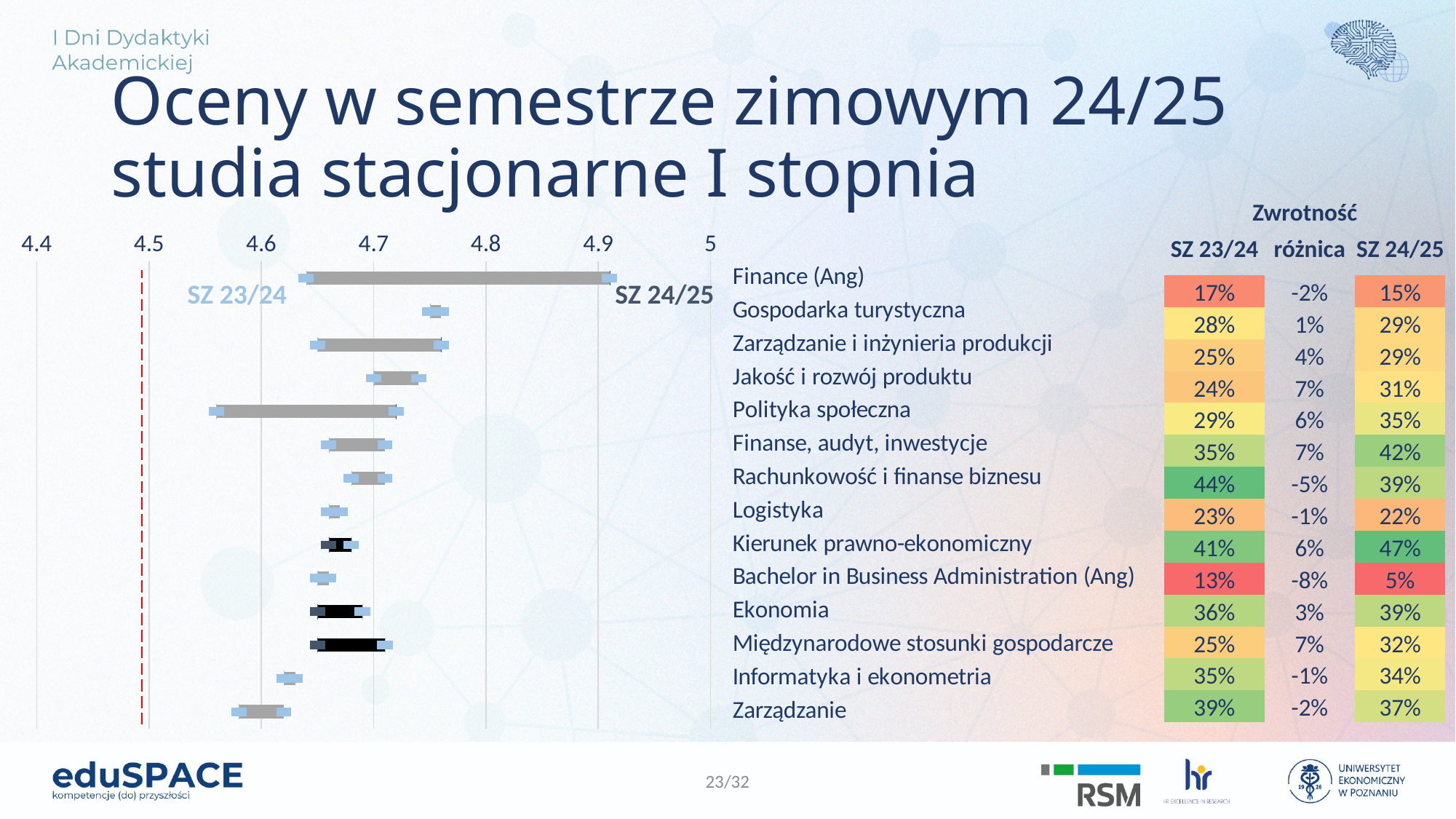
Is the SZ 24/25 grade for Finance (Ang) greater or less than 4.8? greater How many study programmes are plotted in the chart? 14 Is the grade for Informatyka i ekonometria greater or less than 4.7? less Is the SZ 23/24 grade for Polityka społeczna greater or less than 4.6? less Which programme has the larger SZ 24/25 grade, Finance (Ang) or Gospodarka turystyczna? Finance (Ang) What kind of chart is shown on the slide? bar chart What are the two series labels shown on the chart? SZ 23/24 and SZ 24/25 At what value on the x axis is the red dashed vertical line drawn? 4.5 Which programme shows the largest change in grade between SZ 23/24 and SZ 24/25? Finance (Ang) How many semesters (series) does the chart compare? 2 Which programme has the highest grade in SZ 24/25? Finance (Ang)